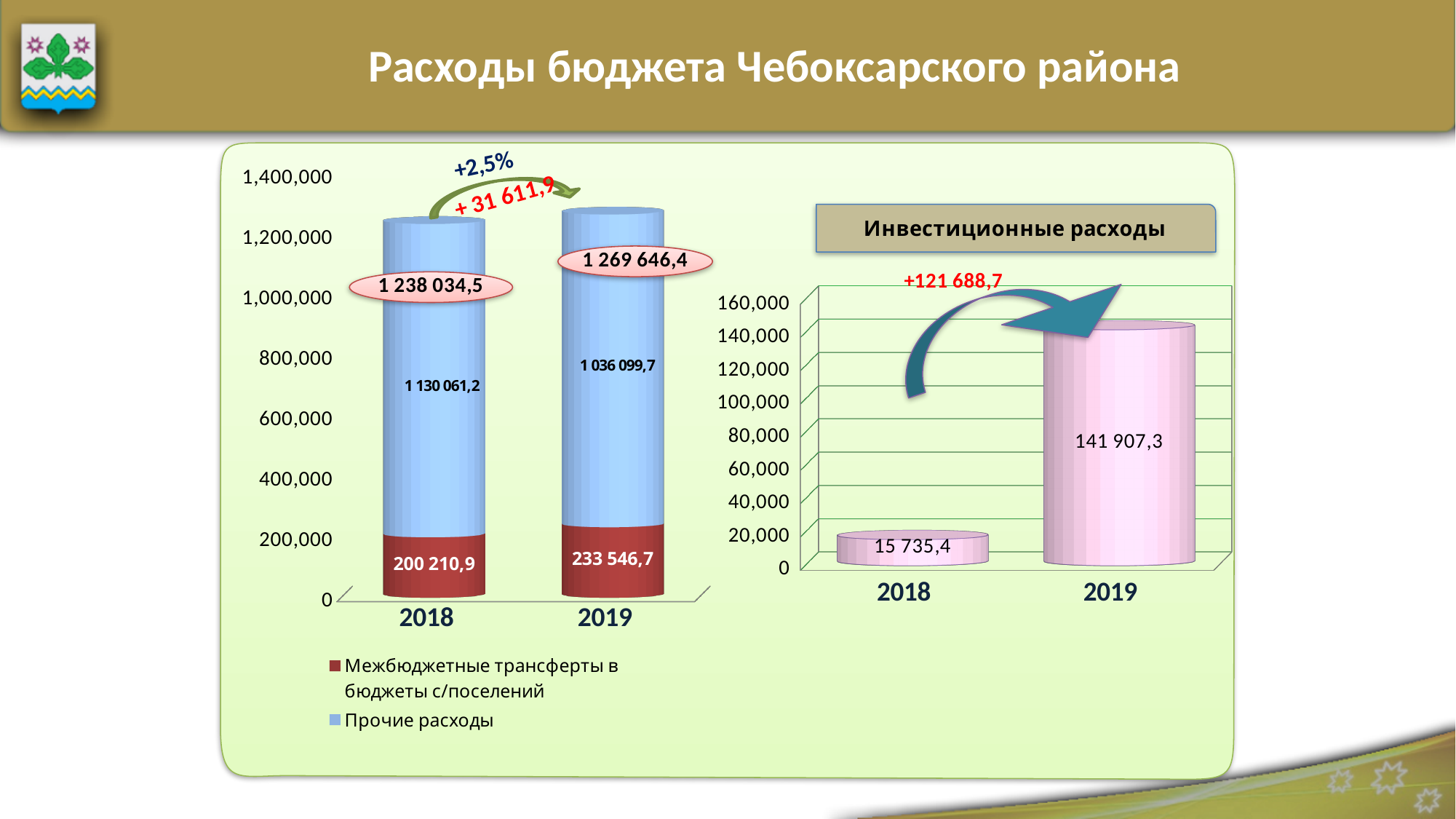
On the left stacked bar chart, what is the total of the 2019 bar? 1 269 646,4 On the left stacked bar chart, which year has the larger value for 'Прочие расходы'? 2018 On the left stacked bar chart, what is the value of 'Межбюджетные трансферты в бюджеты с/поселений' for 2018? 200 210,9 On the left stacked bar chart, what is the value of 'Прочие расходы' for 2019? 1 036 099,7 What kind of chart is the 'Инвестиционные расходы' chart? Bar chart On the left stacked bar chart, what is the total of the 2018 bar? 1 238 034,5 On the 'Инвестиционные расходы' chart, which year has the lowest value? 2018 On the 'Инвестиционные расходы' chart, what is the value for 2018? 15 735,4 On the left stacked bar chart, what is the difference between the 2019 and 2018 values of 'Межбюджетные трансферты в бюджеты с/поселений'? 33 335,8 On the 'Инвестиционные расходы' chart, what is the difference between the 2019 and 2018 values? 126 171,9 On the 'Инвестиционные расходы' chart, what is the value for 2019? 141 907,3 How many series does the legend of the left stacked bar chart list? 2